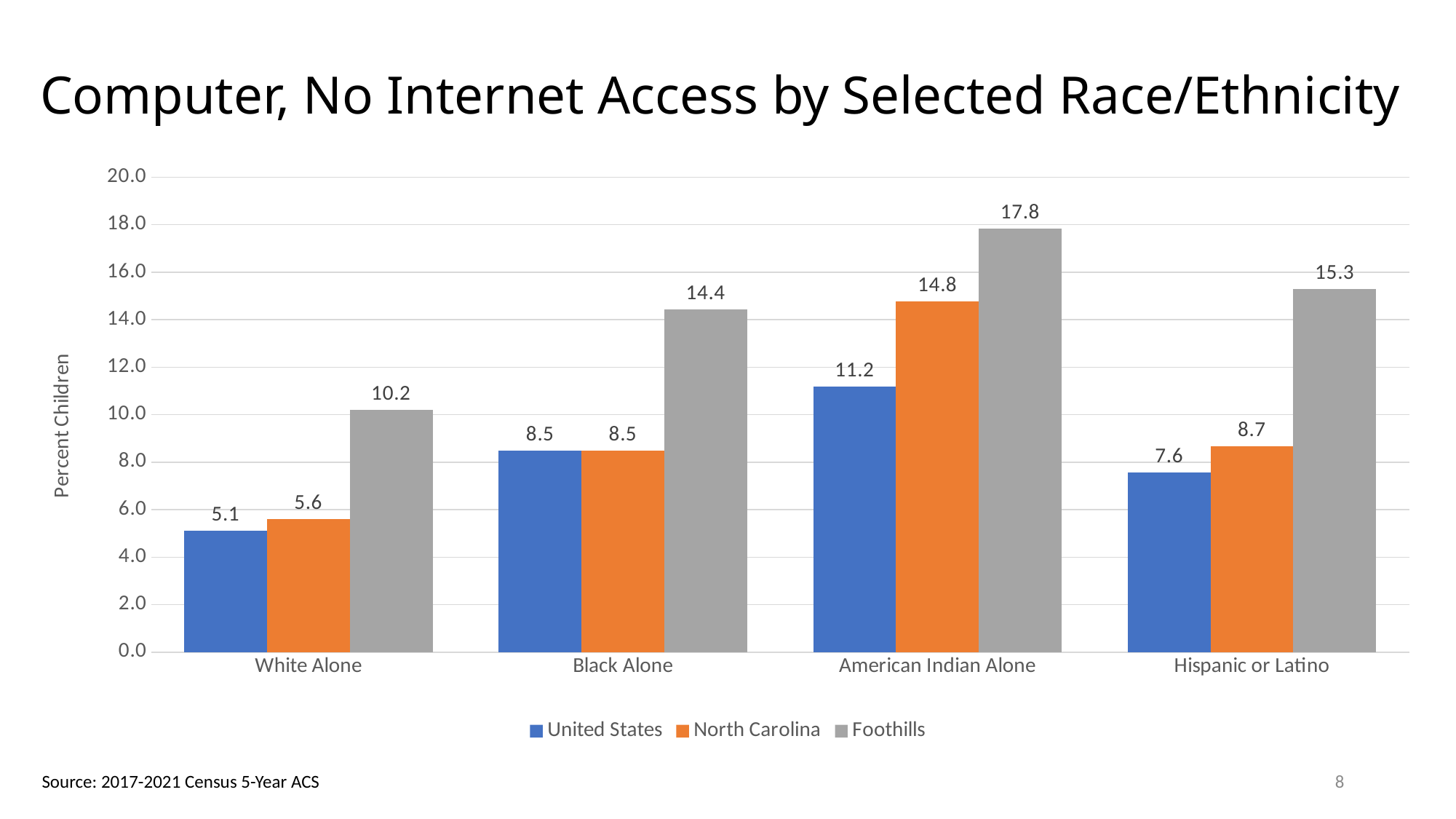
What is the label of the y axis? Percent Children Which race/ethnicity category has the lowest United States value? White Alone How many race/ethnicity categories are shown on the x axis? 4 How many series does the legend list? 3 What is the United States value for White Alone? 5.1 What is the North Carolina value for Hispanic or Latino? 8.7 What kind of chart is shown on the slide? Bar chart What is the Foothills value for American Indian Alone? 17.8 Which race/ethnicity category has the highest Foothills value? American Indian Alone Is the Foothills value for White Alone greater or less than 8.0? greater Which is larger for Hispanic or Latino: the North Carolina value or the United States value? North Carolina What is the difference between the Foothills and United States values for Black Alone? 5.9